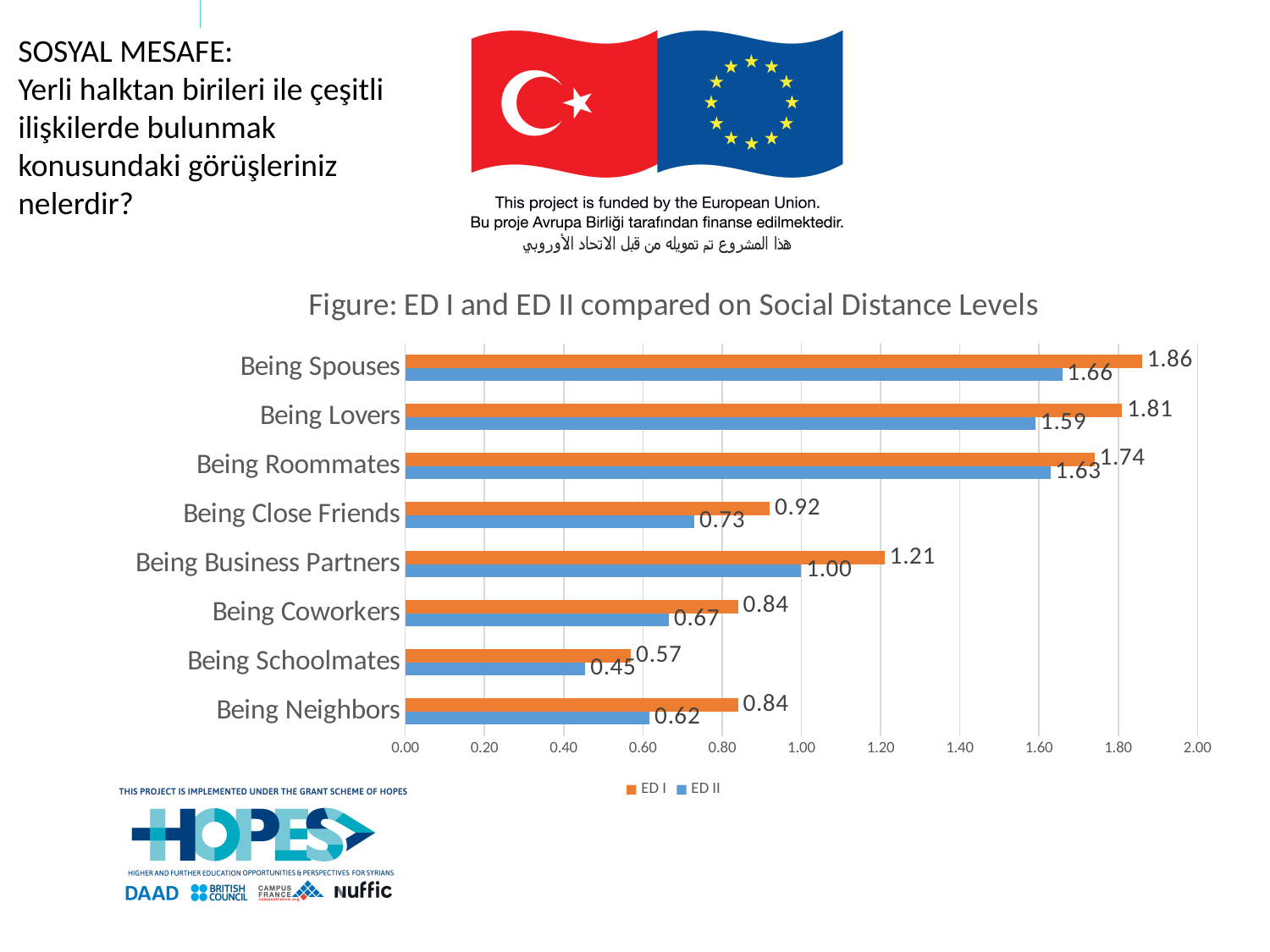
How many categories are shown on the chart? 8 Is the ED II value for Being Neighbors greater or less than 0.80? less Which is larger for Being Roommates, the ED I value or the ED II value? ED I What is the ED I value for Being Spouses? 1.86 Which category has the lowest ED II value? Being Schoolmates What kind of chart is shown on the slide? Bar chart What is the ED II value for Being Lovers? 1.59 What is the difference between the ED I and ED II values for Being Close Friends? 0.19 What is the ED I value for Being Schoolmates? 0.57 How many series does the legend list? 2 What is the ED II value for Being Business Partners? 1.00 Which category has the highest ED I value? Being Spouses